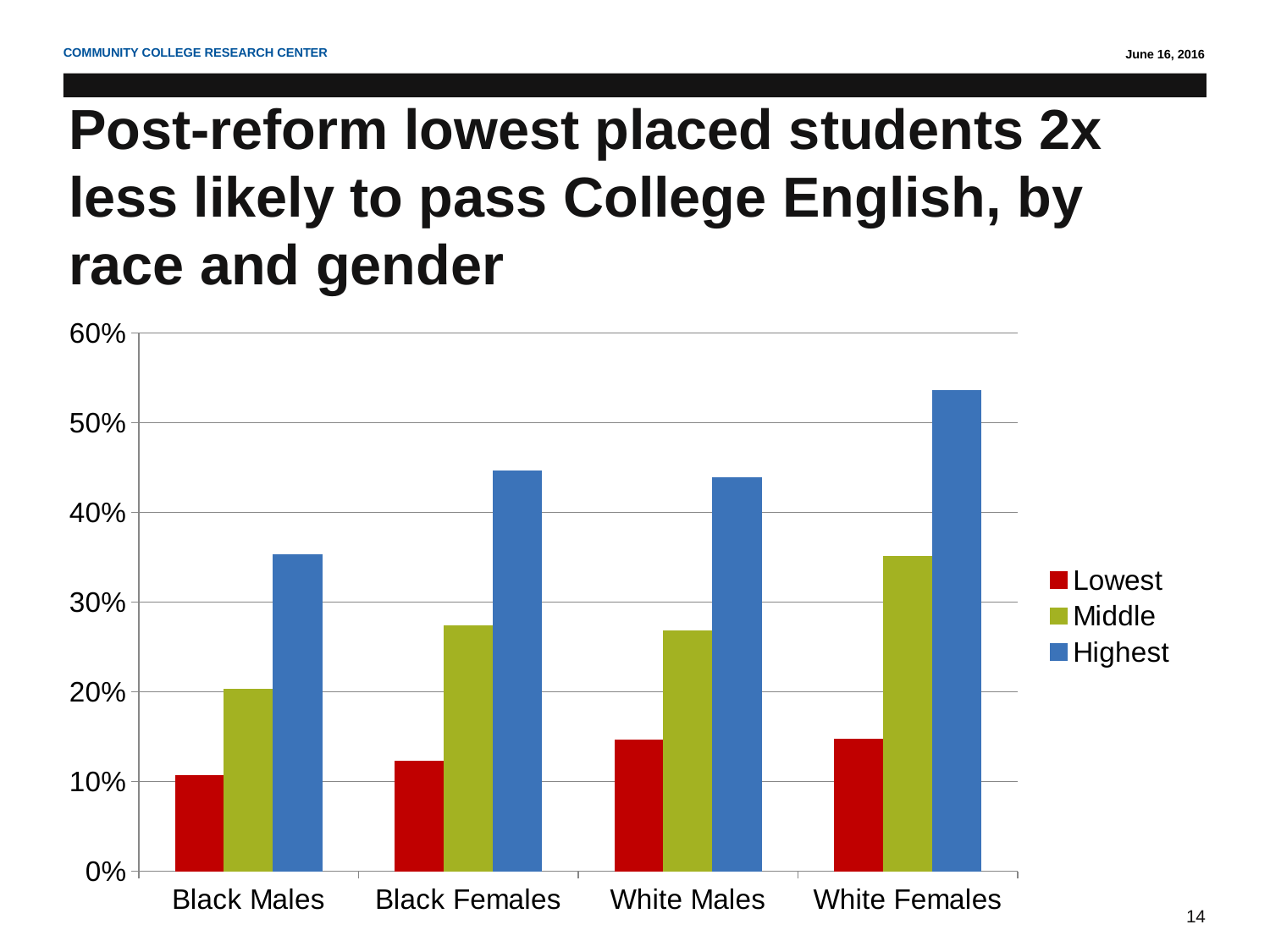
What are the three entries listed in the legend? Lowest, Middle, Highest Which category has the shortest bar for the Lowest series? Black Males What kind of chart is shown on the slide? bar chart Which is larger: the Middle value for White Females or the Middle value for Black Males? White Females How many series does the legend list? 3 Which category has the tallest bar for the Highest series? White Females Is the value for the Lowest series for Black Females greater or less than 20%? less Is the value for the Middle series for White Females greater or less than 30%? greater Is the value for the Highest series for Black Males greater or less than 40%? less How many categories are shown on the x axis? 4 Which is larger: the Highest value for Black Females or the Highest value for Black Males? Black Females